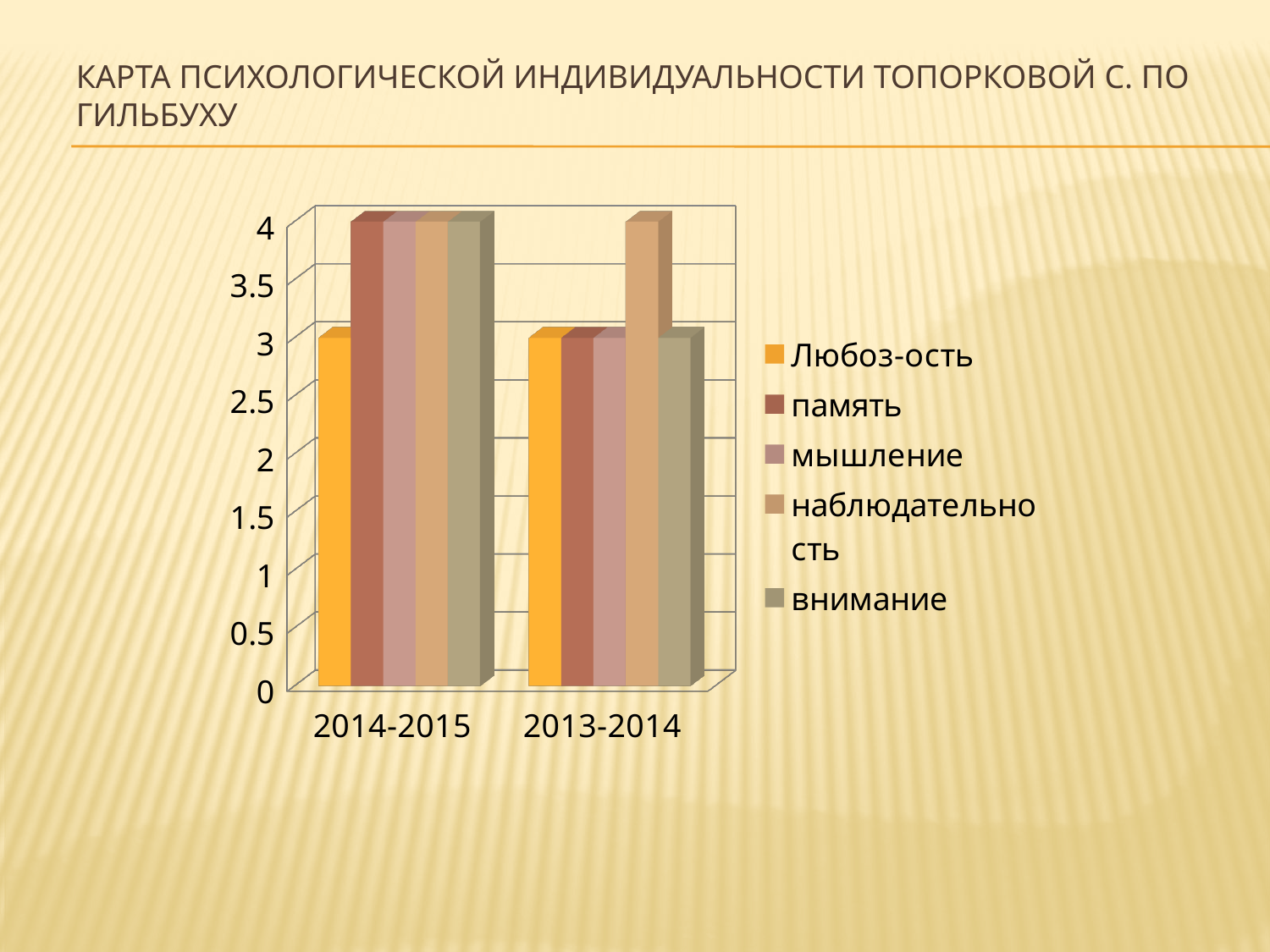
How many categories are shown on the x axis? 2 What is the value for наблюдательность in 2013-2014? 4 Which series is shown in yellow in the legend? Любоз-ость What is the value for Любоз-ость in 2014-2015? 3 What kind of chart is shown on the slide? bar chart What is the value for память in 2014-2015? 4 What is the difference between the value for память in 2014-2015 and in 2013-2014? 1 What is the value for внимание in 2013-2014? 3 Which series has the lowest value in 2014-2015? Любоз-ость How many series does the legend list? 5 Which series has the highest value in 2013-2014? наблюдательность Which is larger: the value for мышление in 2014-2015 or in 2013-2014? 2014-2015